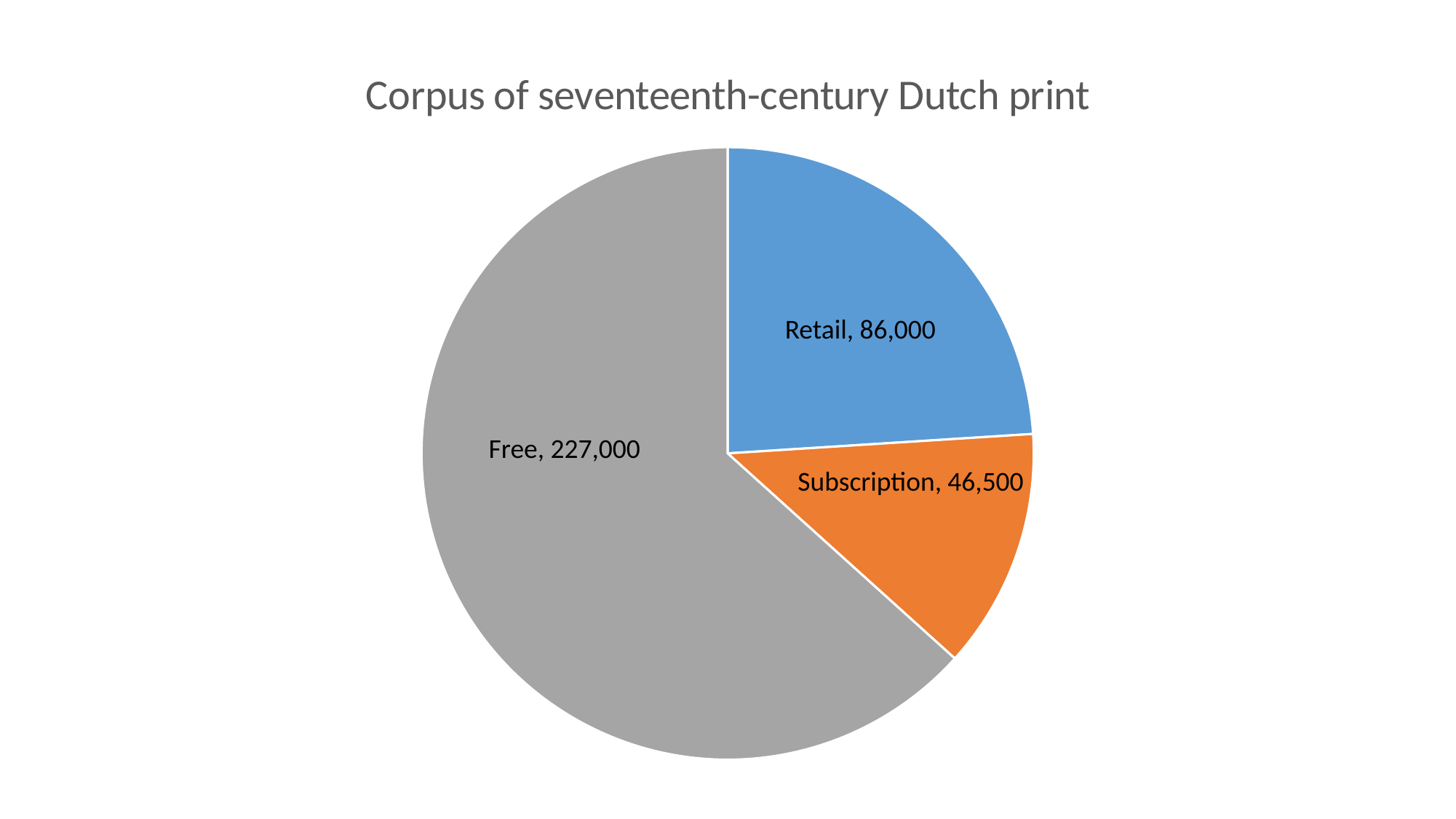
What is the total of all three slices? 359,500 What is the value of the Retail slice? 86,000 What is the value of the Free slice? 227,000 What is the value of the Subscription slice? 46,500 What kind of chart is shown on the slide? Pie chart What is the difference between the Free and Retail values? 141,000 Which category has the smallest slice? Subscription Which is larger, Retail or Subscription? Retail What is the title of the chart? Corpus of seventeenth-century Dutch print How many slices does the pie chart have? 3 What is the difference between the Retail and Subscription values? 39,500 Which category has the largest slice? Free